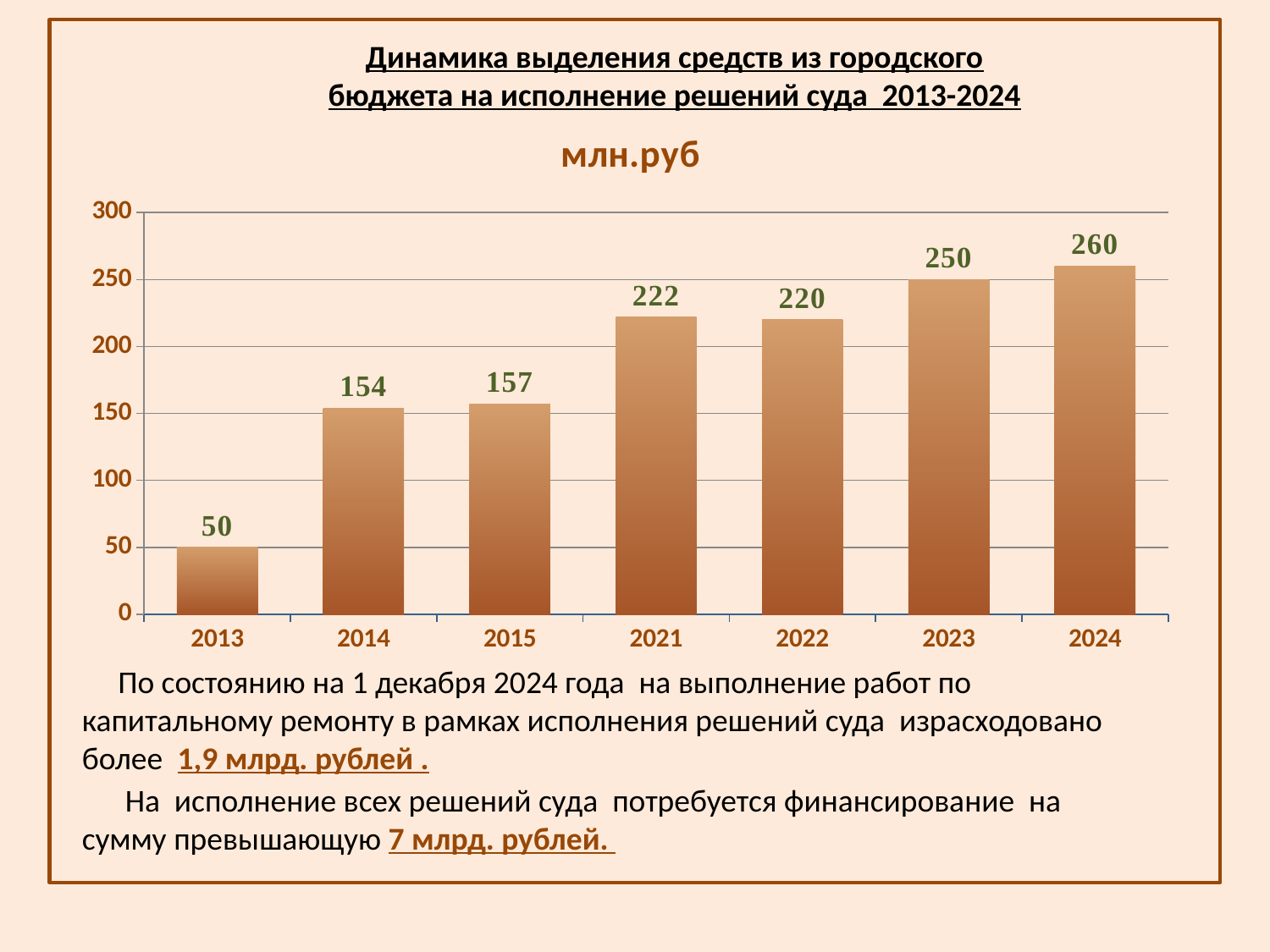
Which year has the highest value? 2024 What is the value for 2021? 222 What kind of chart is shown on the slide? bar chart Which year has the lowest value? 2013 What unit is given in the chart title? млн.руб Which is larger, the value for 2021 or the value for 2022? 2021 What is the difference between the values for 2015 and 2014? 3 Is the value for 2023 greater or less than 200? greater What is the difference between the values for 2024 and 2013? 210 How many years are shown on the x axis? 7 What is the value for 2013? 50 What is the value for 2024? 260